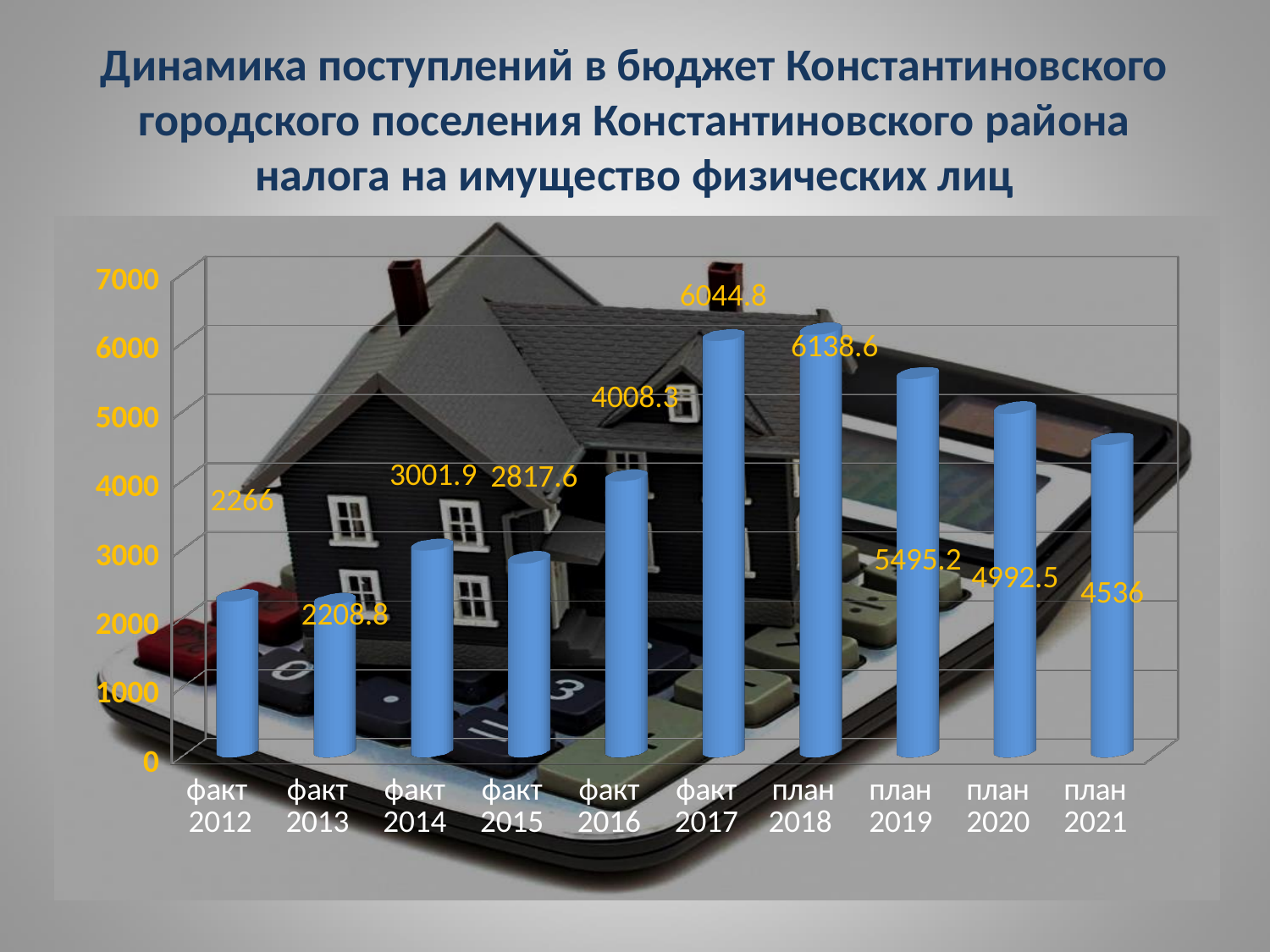
How many categories are shown on the x axis? 10 Is the value for факт 2017 greater or less than 5000? greater What is the value for план 2019? 5495.2 What is the difference between the values for факт 2014 and факт 2015? 184.3 What is the value for факт 2016? 4008.3 Which category has the highest value? план 2018 What is the difference between the values for план 2018 and факт 2017? 93.8 Which category has the lowest value? факт 2013 Do the values rise or fall from план 2018 to план 2021? fall Which is larger, the value for план 2020 or the value for план 2021? план 2020 What is the value for факт 2012? 2266 What kind of chart is shown on the slide? bar chart